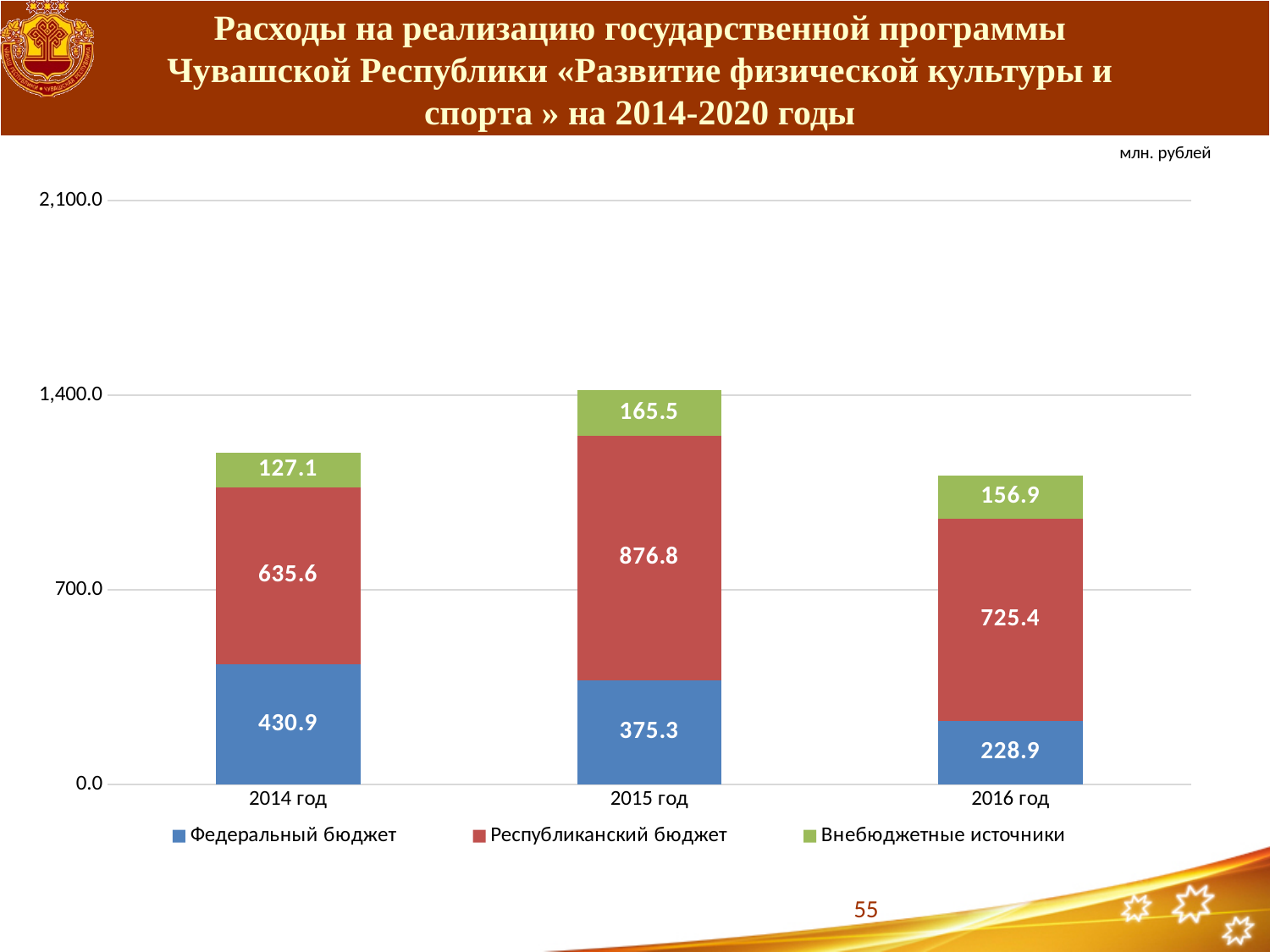
What is the value of Федеральный бюджет for 2014 год? 430.9 What is the total of the stacked bar for 2015 год? 1417.6 What is the total of the stacked bar for 2016 год? 1111.2 How many series does the legend list? 3 What kind of chart is shown on the slide? Stacked bar chart In which year is the Федеральный бюджет value the lowest? 2016 год How many years are shown on the x axis? 3 What is the value of Республиканский бюджет for 2015 год? 876.8 What is the value of Внебюджетные источники for 2016 год? 156.9 In which year is the Республиканский бюджет value the highest? 2015 год What is the difference between the Республиканский бюджет values for 2015 год and 2014 год? 241.2 Which is larger: Внебюджетные источники in 2014 год or in 2016 год? 2016 год